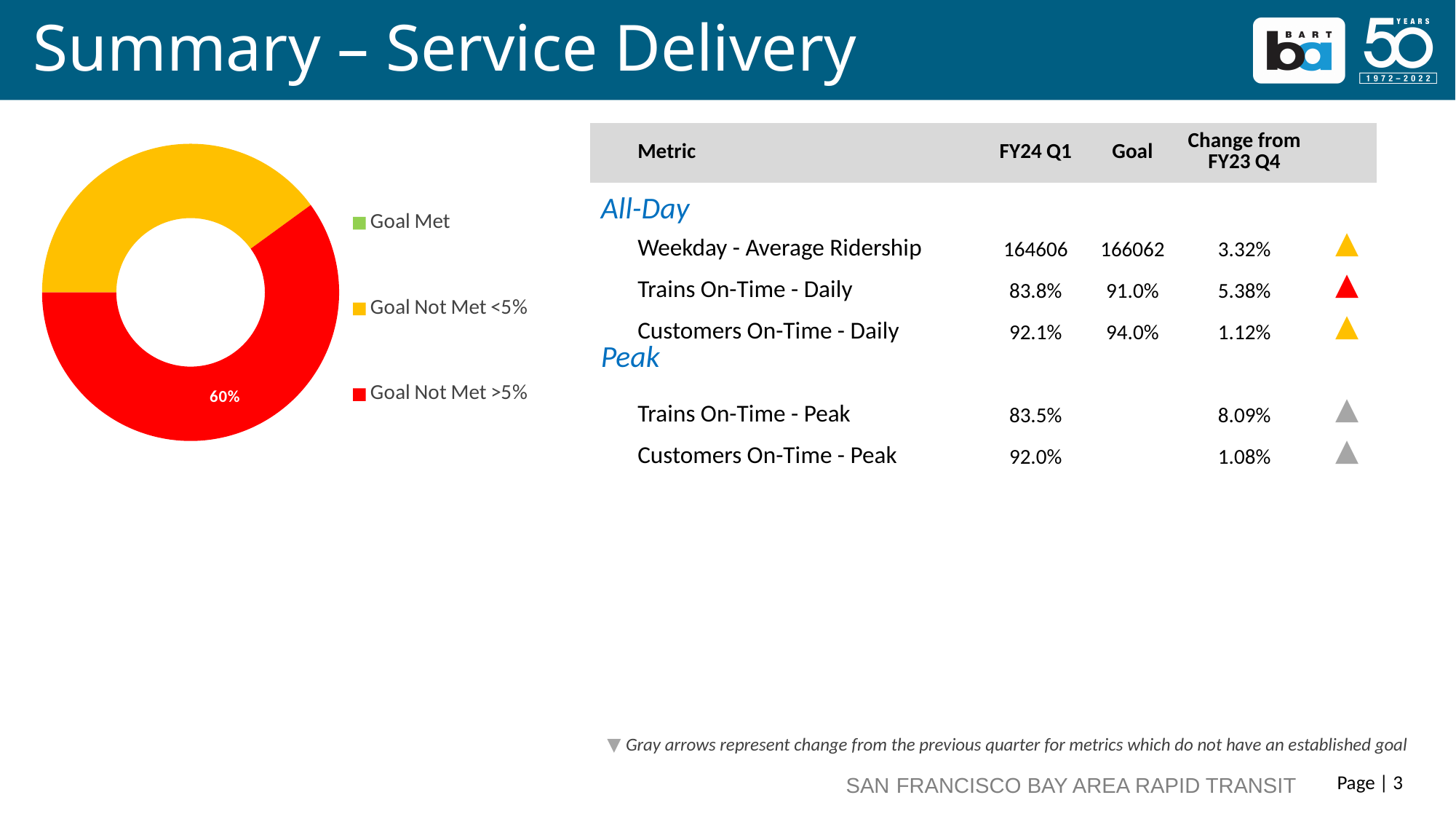
What colour does the legend assign to Goal Met in the doughnut chart? Green How many slices are visibly drawn in the doughnut chart? 2 Is the share for Goal Not Met >5% in the doughnut chart greater or less than 50%? greater Which category has the largest slice in the doughnut chart? Goal Not Met >5% What percentage is labelled on the Goal Not Met >5% slice of the doughnut chart? 60% How many categories does the legend of the doughnut chart list? 3 Which slice is larger in the doughnut chart, Goal Not Met <5% or Goal Not Met >5%? Goal Not Met >5% What colour represents Goal Not Met <5% in the doughnut chart? Yellow What share of the doughnut chart does the Goal Not Met >5% category take? 60% What kind of chart is shown on the left of the slide? Pie (doughnut) chart Is the share for Goal Not Met <5% in the doughnut chart greater or less than 50%? less